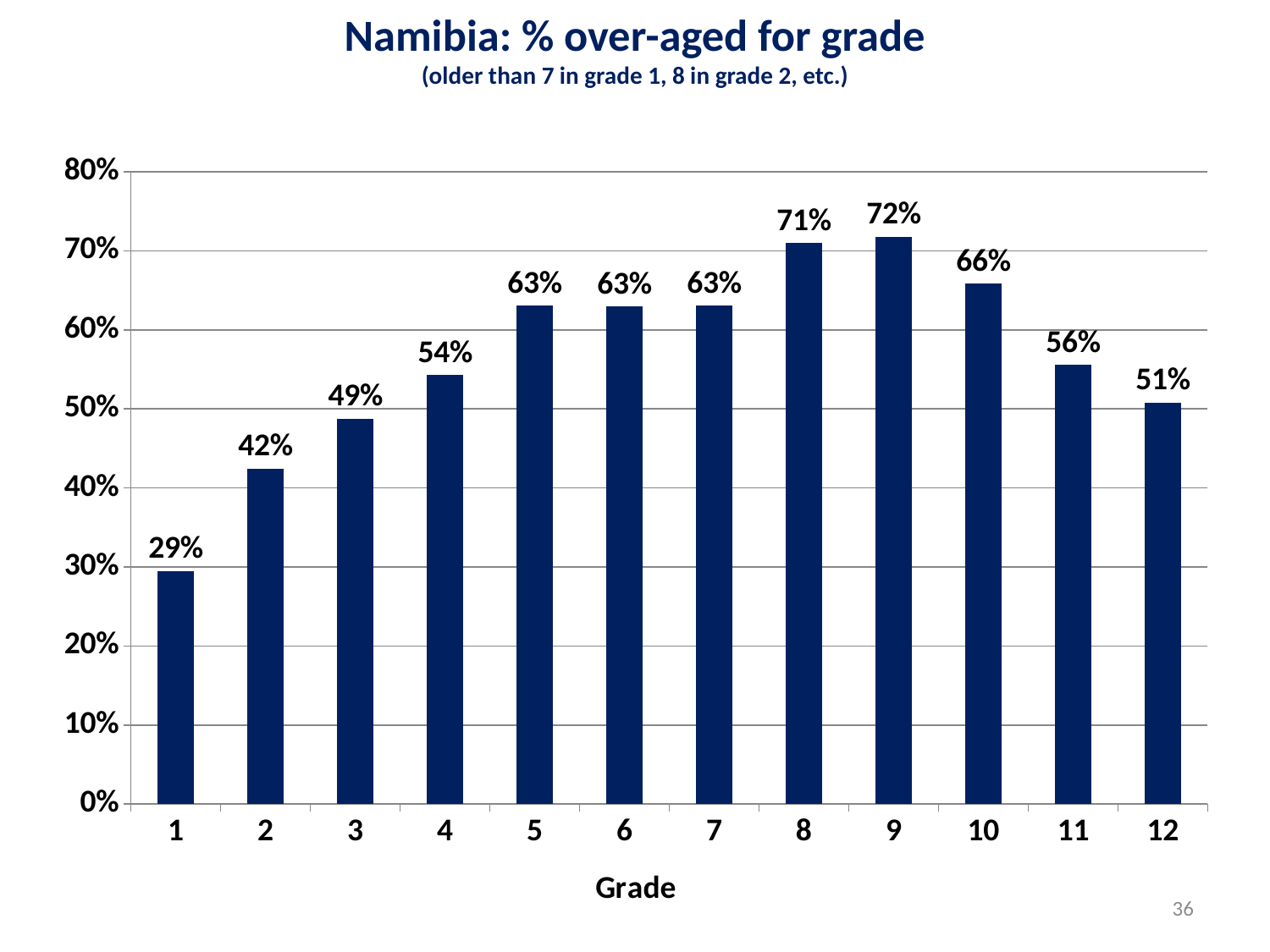
What is the difference in percentage points between grade 8 and grade 4? 17 How many grades are shown on the x axis? 12 What is the percentage over-aged for grade 12? 51% Which grade has the highest percentage over-aged? 9 Which has a higher percentage over-aged, grade 2 or grade 11? Grade 11 Which grade has the lowest percentage over-aged? 1 What is the title of the chart? Namibia: % over-aged for grade What kind of chart is shown on the slide? Bar chart What is the percentage over-aged for grade 1? 29% What is the percentage over-aged for grade 10? 66% Is the value for grade 3 greater or less than 50%? less What is the difference in percentage points between grade 9 and grade 1? 43